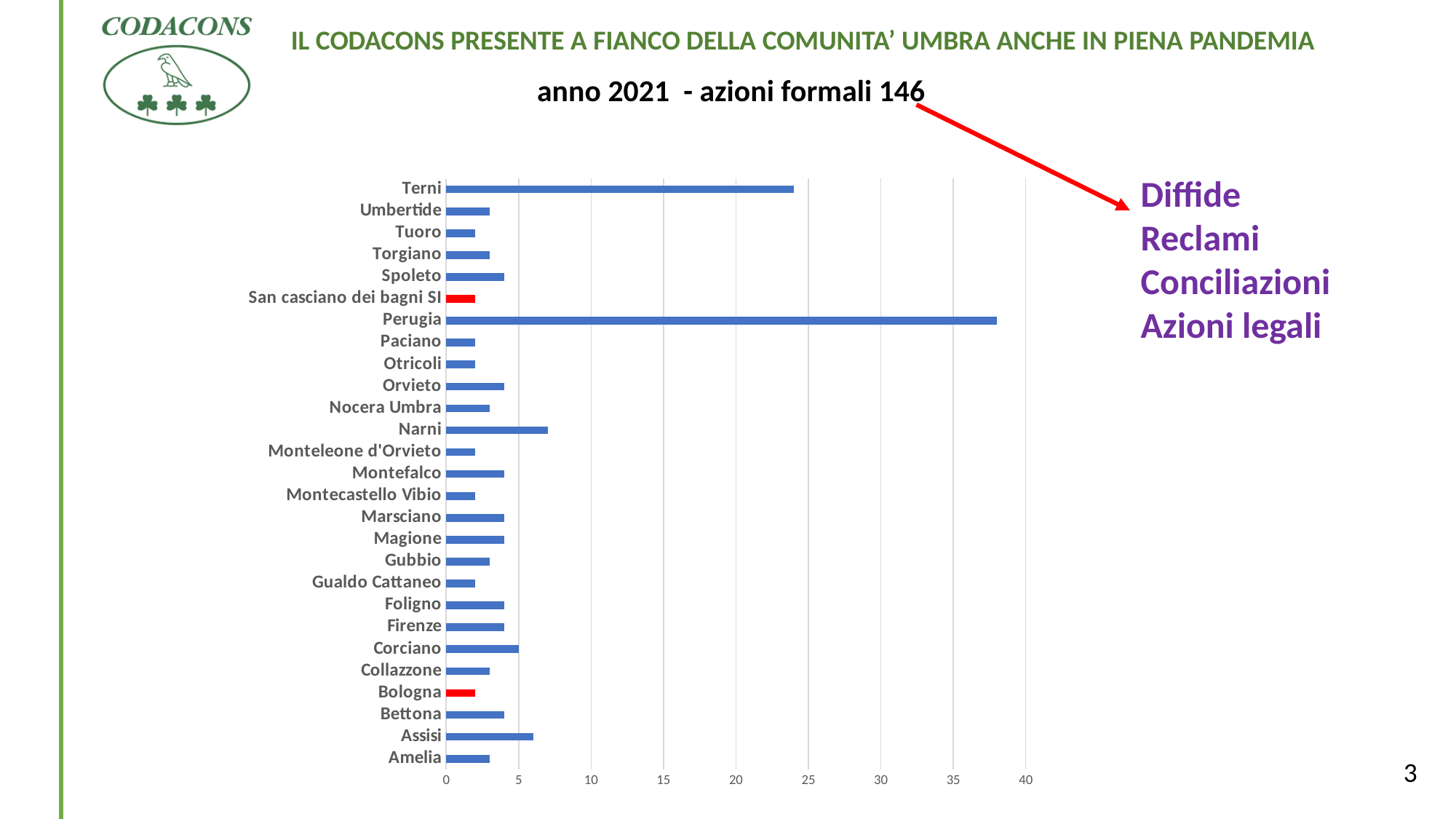
Is the value for Perugia greater or less than 40? less What kind of chart is shown on the slide? bar chart Is the value for Terni greater or less than 25? less Which category has the highest value in the chart? Perugia Which two categories are drawn with red bars instead of blue? San casciano dei bagni SI and Bologna How many categories are plotted in the chart? 27 Is the value for Terni greater or less than 20? greater Which has a larger value, Perugia or Terni? Perugia Which has a larger value, Terni or Narni? Terni